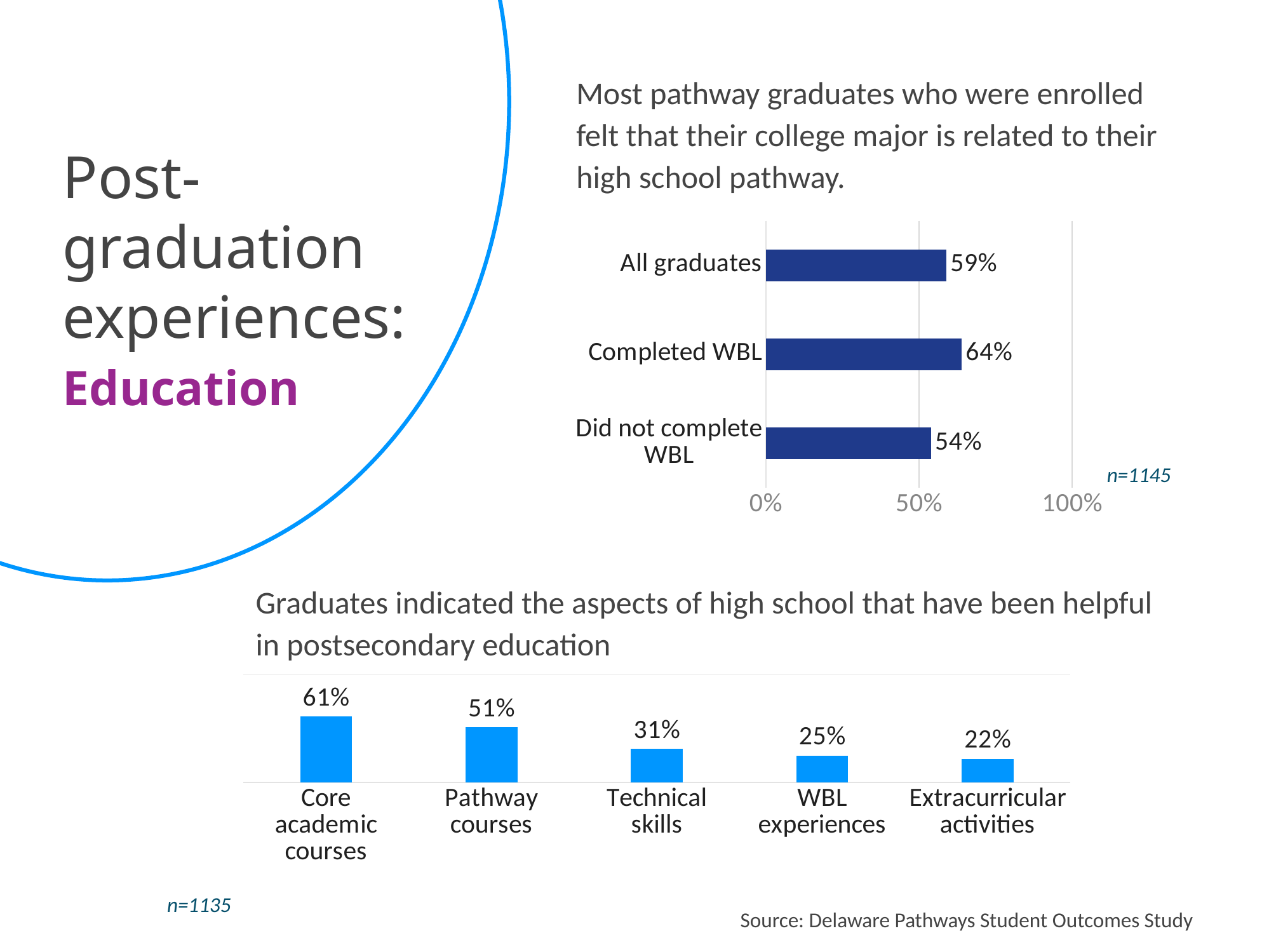
In the top chart about college major related to high school pathway, which category has the lowest value? Did not complete WBL In the bottom chart about helpful aspects of high school, which is larger: WBL experiences or Technical skills? Technical skills In the bottom chart about helpful aspects of high school, which category has the lowest value? Extracurricular activities In the bottom chart about helpful aspects of high school, which category has the highest value? Core academic courses In the top chart about college major related to high school pathway, what is the value for All graduates? 59% In the bottom chart about helpful aspects of high school, what is the difference between Core academic courses and Pathway courses? 10% In the bottom chart about helpful aspects of high school, how many categories are shown? 5 In the top chart about college major related to high school pathway, how many categories are shown? 3 In the bottom chart about helpful aspects of high school, what is the value for Technical skills? 31% In the top chart about college major related to high school pathway, what is the difference between Completed WBL and Did not complete WBL? 10% In the top chart about college major related to high school pathway, what is the value for Completed WBL? 64% In the top chart about college major related to high school pathway, what kind of chart is it? Bar chart